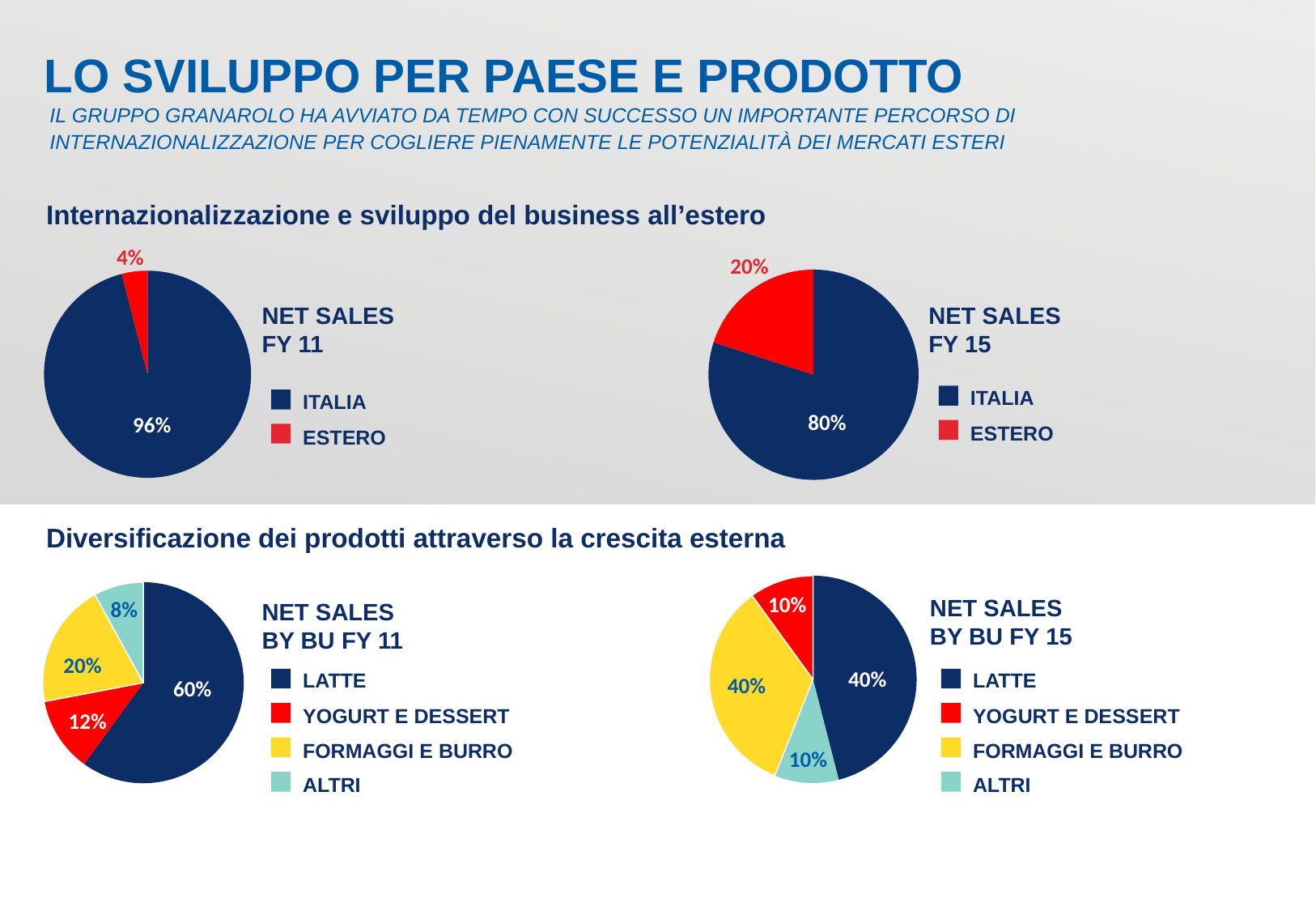
In the NET SALES FY 11 pie chart, what share is ESTERO? 4% What is the difference between the ESTERO share in the NET SALES FY 15 chart and the ESTERO share in the NET SALES FY 11 chart? 16% In the NET SALES BY BU FY 11 pie chart, what share is FORMAGGI E BURRO? 20% In the NET SALES BY BU FY 11 pie chart, which category has the largest share? LATTE How many entries does the legend of the NET SALES FY 11 chart list? 2 In the NET SALES FY 15 pie chart, what share is ITALIA? 80% In the NET SALES BY BU FY 11 pie chart, what colour represents ALTRI? Light teal How many slices does the NET SALES BY BU FY 15 pie chart have? 4 What type of chart is the NET SALES BY BU FY 11 chart? Pie chart In the NET SALES BY BU FY 15 pie chart, what share is YOGURT E DESSERT? 10% In the NET SALES BY BU FY 11 pie chart, which category has the smallest share? ALTRI In the NET SALES BY BU FY 15 pie chart, which is larger: the share of FORMAGGI E BURRO or the share of ALTRI? FORMAGGI E BURRO